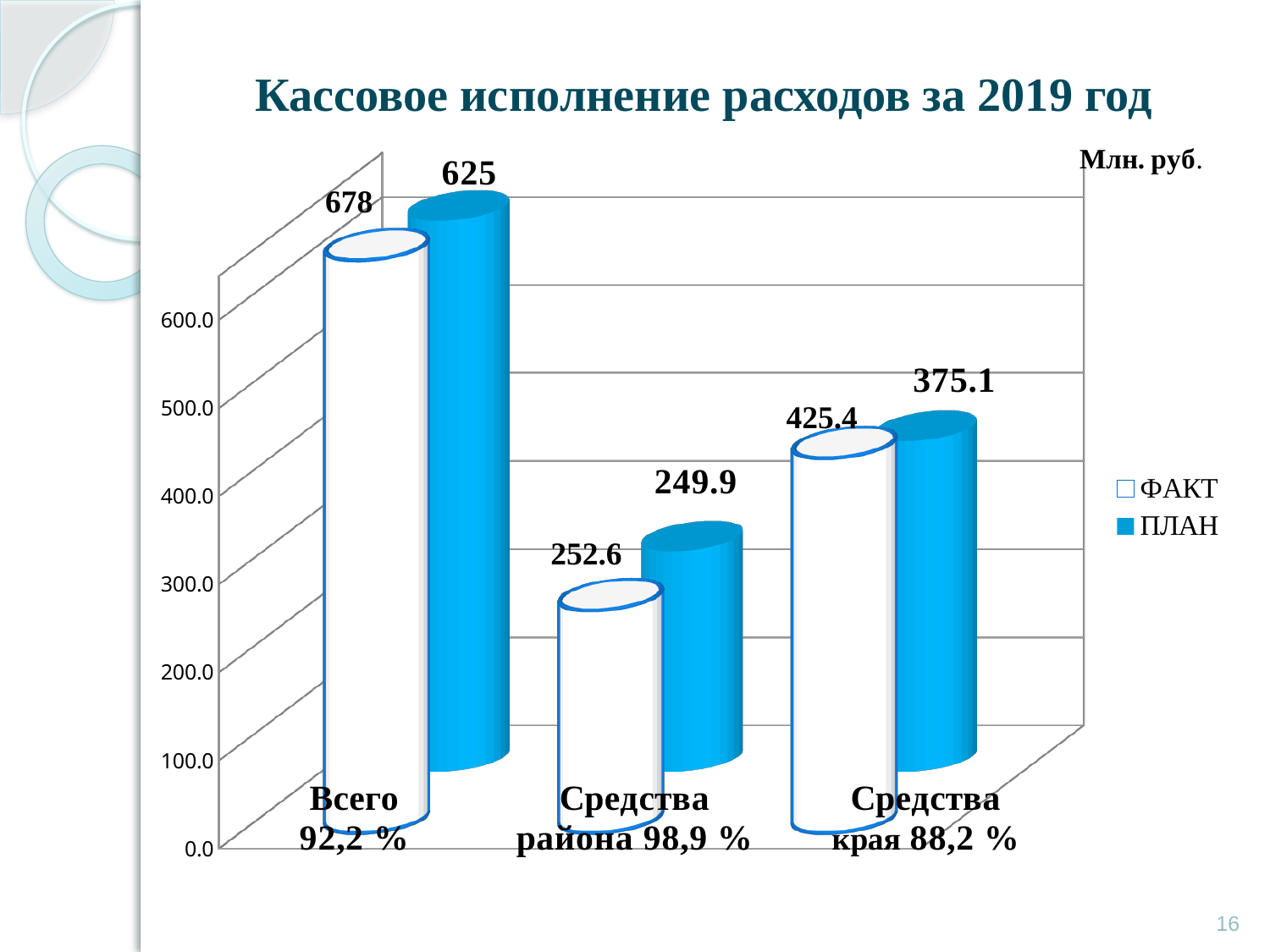
What value is labelled on the blue (ПЛАН) bar for Средства края 88,2 %? 375.1 What unit is indicated in the top right of the chart? Млн. руб. What value is labelled on the blue (ПЛАН) bar for Всего 92,2 %? 625 What value is labelled on the white (ФАКТ) bar for Всего 92,2 %? 678 What is the difference between the two labelled values for Средства края 88,2 % (425.4 and 375.1)? 50.3 What is the title of the chart? Кассовое исполнение расходов за 2019 год Which category has the highest labelled value on the white (ФАКТ) bar? Всего 92,2 % How many categories are shown on the x axis? 3 What value is labelled on the white (ФАКТ) bar for Средства района 98,9 %? 252.6 What is the difference between the two labelled values for Всего 92,2 % (678 and 625)? 53 What kind of chart is shown on the slide? bar chart How many series does the legend list? 2